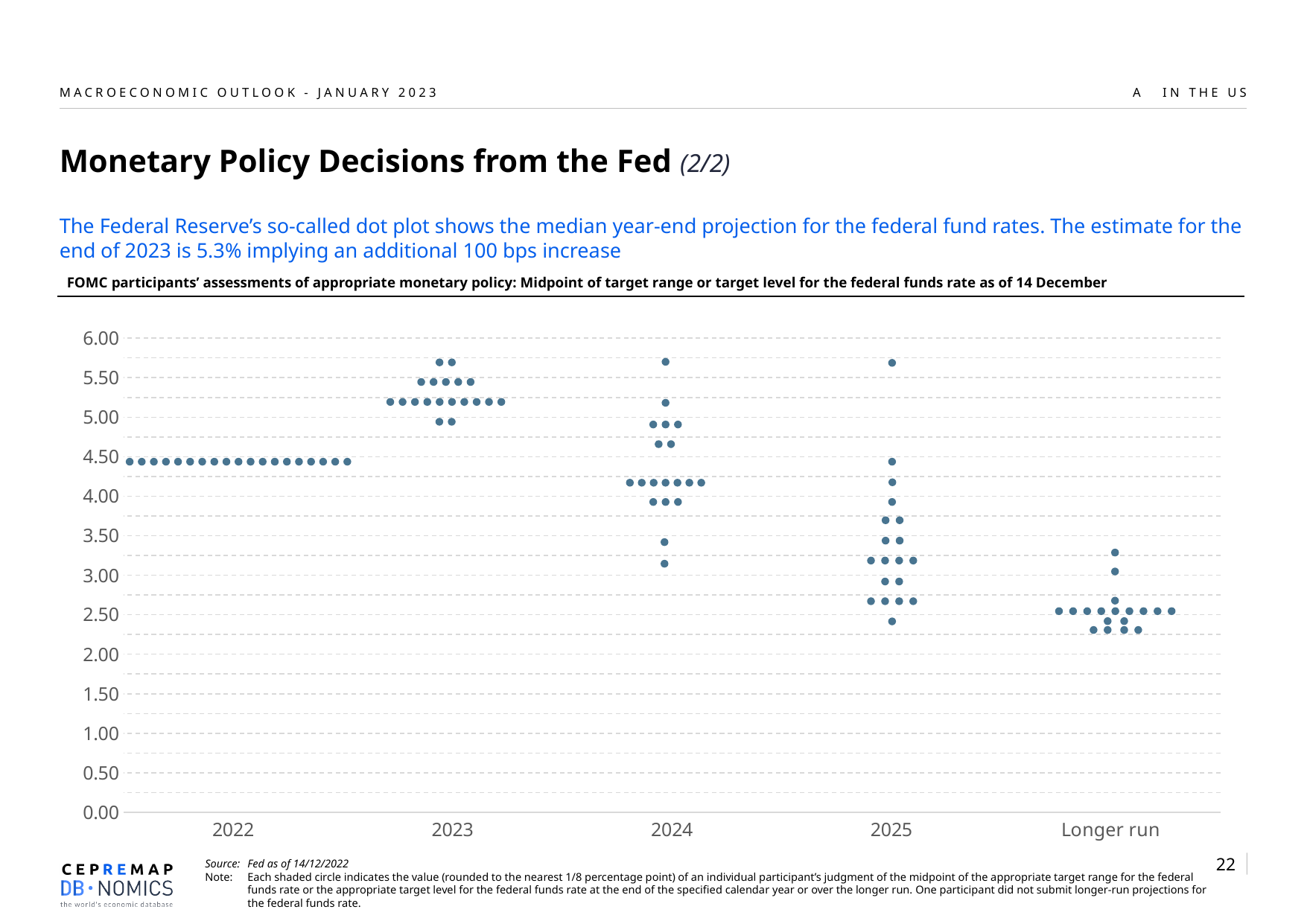
Are the dots for 2022 greater or less than 4.00? greater Are the dots for 2022 greater or less than 5.00? less Which category has higher dots overall, 2022 or 2023? 2023 How many categories are shown on the x axis of the chart? 5 Which category has higher dots overall, 2024 or Longer run? 2024 According to the slide text, what is the median estimate for the federal funds rate at the end of 2023? 5.3% From 2023 to Longer run, do the projected rates rise or fall along the x axis? fall Is the highest dot for 2023 greater or less than 5.50? greater What kind of chart is shown on the slide? Dot plot (scatter chart) How many dots are plotted for 2022? 19